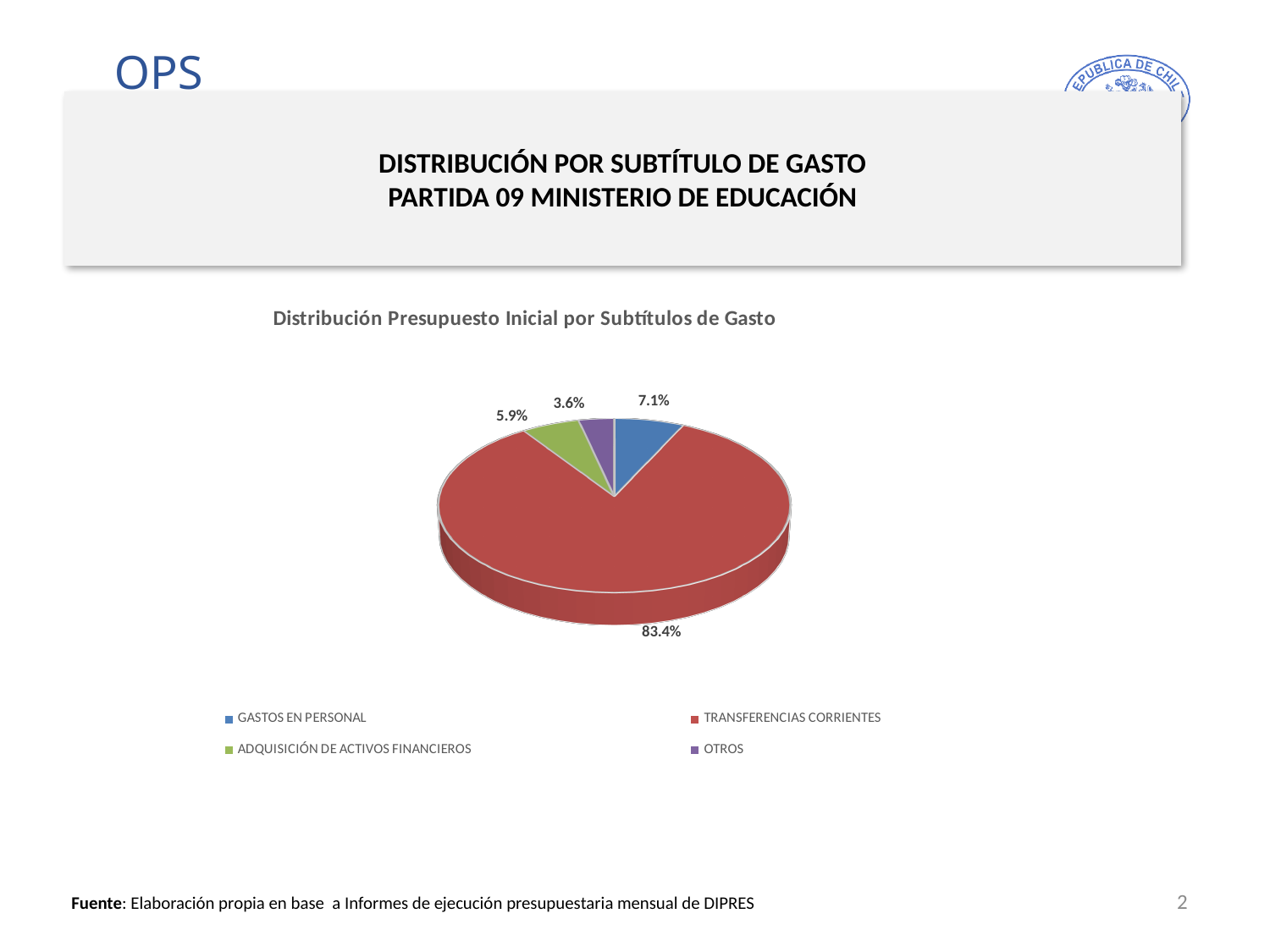
What share of the pie does GASTOS EN PERSONAL represent? 7.1% Which category has the largest slice of the pie? TRANSFERENCIAS CORRIENTES What share of the pie does ADQUISICIÓN DE ACTIVOS FINANCIEROS represent? 5.9% Which colour represents OTROS in the pie chart? Purple Which category has the smallest slice of the pie? OTROS How many categories does the pie chart show? 4 What share of the pie does TRANSFERENCIAS CORRIENTES represent? 83.4% What is the title of the chart? Distribución Presupuesto Inicial por Subtítulos de Gasto What is the difference in percentage points between the share for TRANSFERENCIAS CORRIENTES and the share for GASTOS EN PERSONAL? 76.3% Which is larger, the share for GASTOS EN PERSONAL or the share for ADQUISICIÓN DE ACTIVOS FINANCIEROS? GASTOS EN PERSONAL What kind of chart is shown on the slide? Pie chart